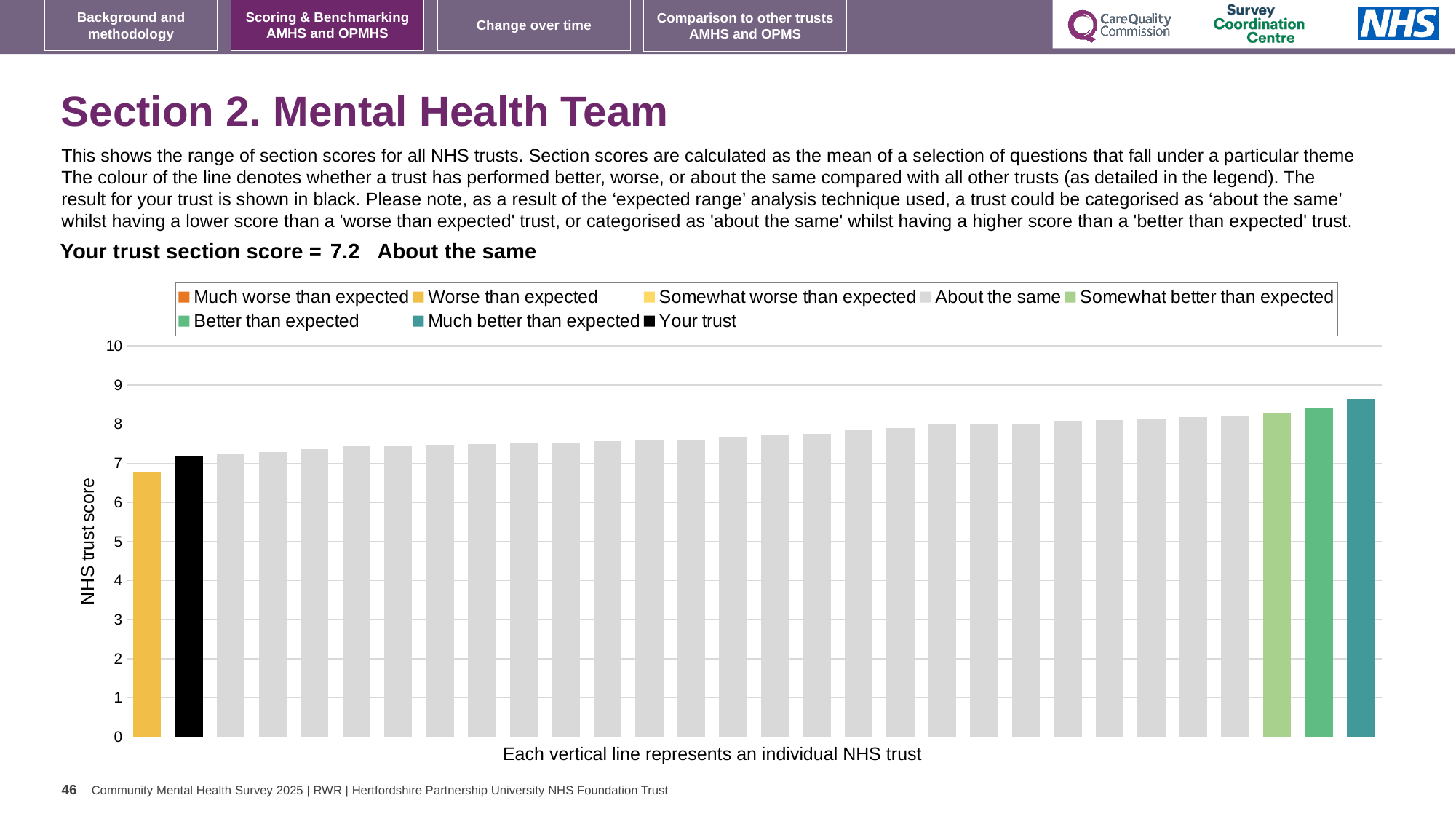
Which is larger, the 'Your trust' bar or the 'Worse than expected' bar? Your trust Is the value of the 'Much better than expected' bar greater or less than 8? greater How many entries does the chart legend list? 8 Which category does your trust fall into according to the slide? About the same What is the label on the vertical axis of the chart? NHS trust score What kind of chart is shown on the slide? bar chart Which legend category does the tallest bar belong to? Much better than expected Which legend category does the shortest bar belong to? Worse than expected What is the section score for your trust shown on the slide? 7.2 How many bars are coloured as 'Worse than expected'? 1 Do the bar values rise or fall from left to right along the x axis? rise Is the value of the 'Worse than expected' bar greater or less than 7? less